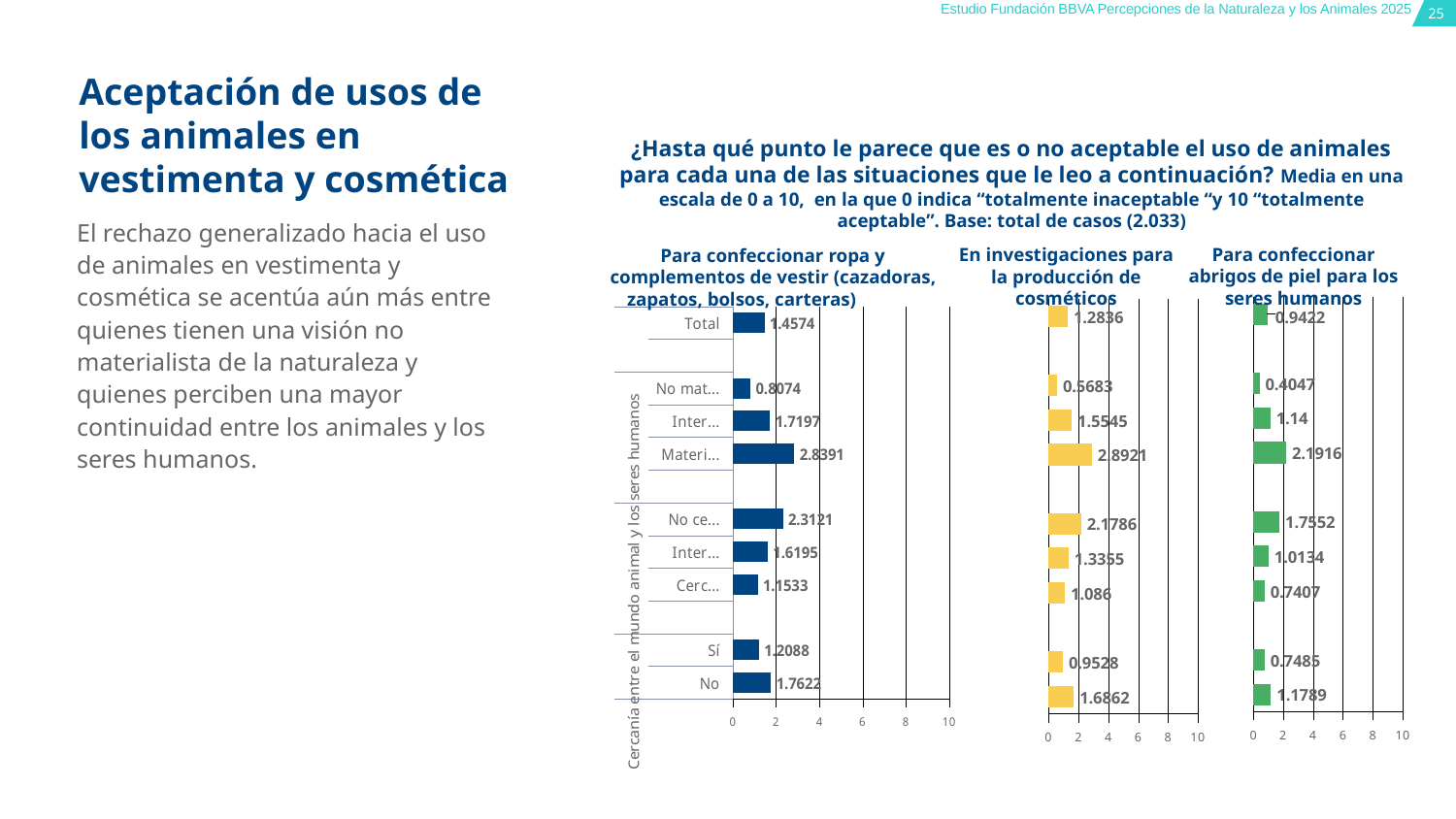
In the chart 'Para confeccionar abrigos de piel para los seres humanos', what is the value for Total? 0.9422 What colour are the bars in the chart 'Para confeccionar abrigos de piel para los seres humanos'? Green In the chart 'Para confeccionar ropa y complementos de vestir', which has the larger value, 'Sí' or 'No'? No In the chart 'En investigaciones para la producción de cosméticos', what is the value for Total? 1.2836 In the chart 'Para confeccionar abrigos de piel para los seres humanos', what is the lowest value shown? 0.4047 In the chart 'Para confeccionar ropa y complementos de vestir', what is the value for the category 'No'? 1.7622 In the chart 'Para confeccionar ropa y complementos de vestir', what is the highest value shown? 2.8391 In the chart 'Para confeccionar abrigos de piel para los seres humanos', what is the value for the category 'Sí'? 0.7485 In the chart 'Para confeccionar ropa y complementos de vestir', what is the value for Total? 1.4574 What type of chart is used on this slide? Bar chart How many bars are shown in the chart 'Para confeccionar ropa y complementos de vestir'? 9 In the chart 'En investigaciones para la producción de cosméticos', what is the difference between the values for 'No' and 'Sí'? 0.7334